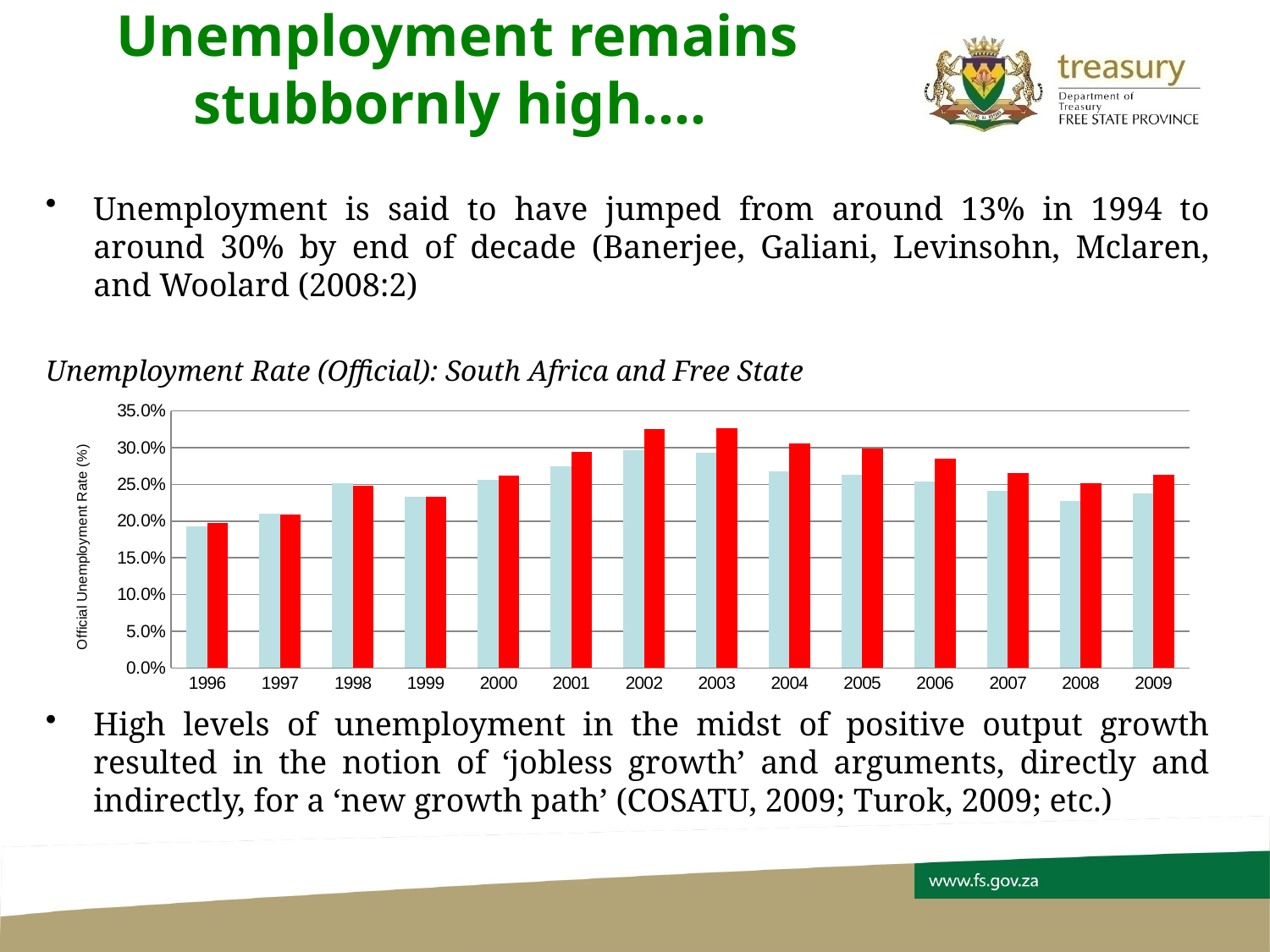
In which year is the light blue bar lowest? 1996 Do the light blue bars rise or fall from 1996 to 2002? Rise In 2007, which bar is taller, the red bar or the light blue bar? The red bar Is the value of the red bar for 2009 greater or less than 25.0%? greater What is the title of the chart? Unemployment Rate (Official): South Africa and Free State How many years are shown on the x axis of the chart? 14 What kind of chart is shown on the slide? Bar chart Is the value of the light blue bar for 1996 greater or less than 20.0%? less Is the value of the red bar for 2003 greater or less than 30.0%? greater What is the label on the vertical axis of the chart? Official Unemployment Rate (%)